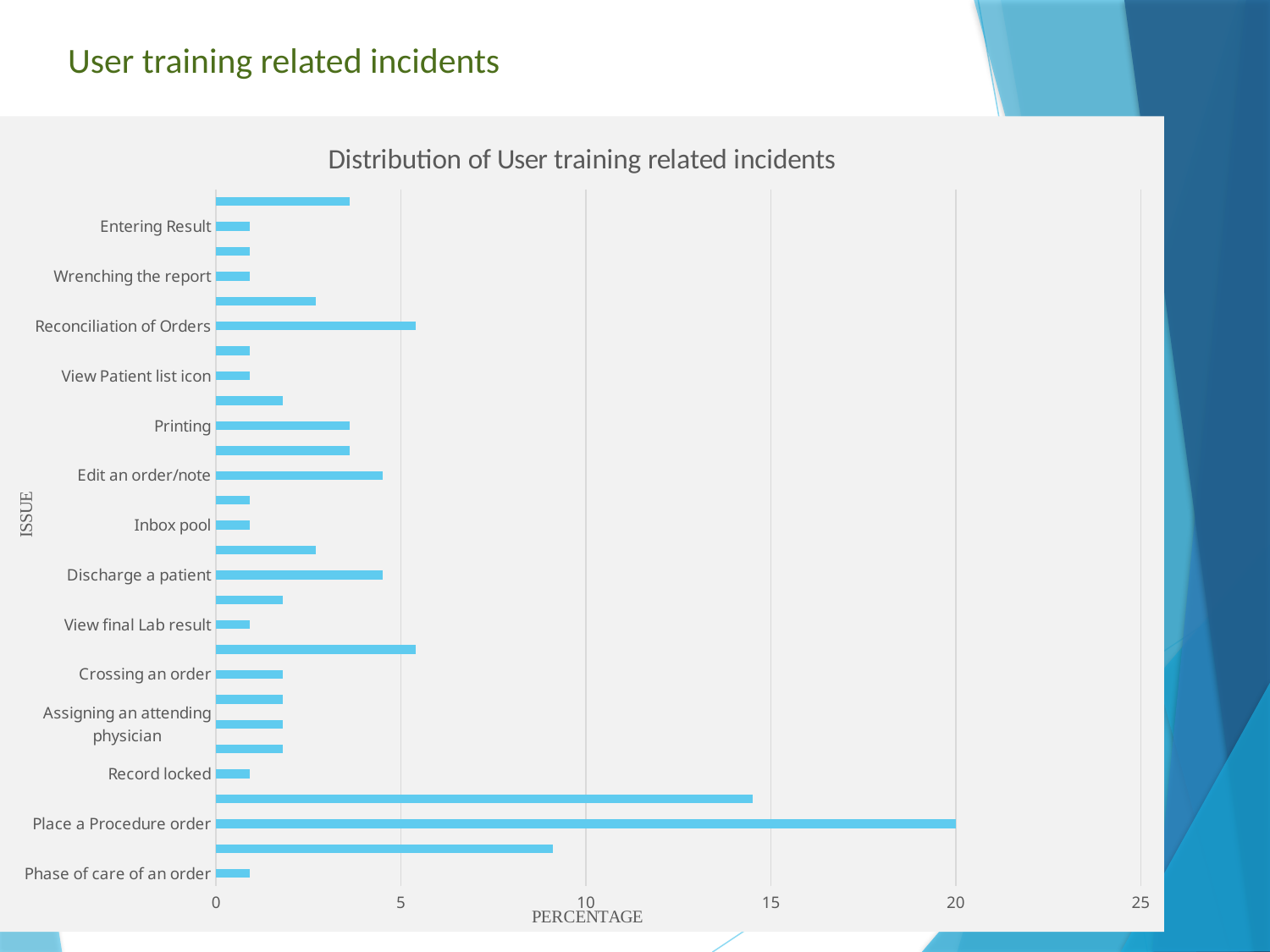
Is the value for Record locked greater or less than 5? less Which is larger, the value for Reconciliation of Orders or the value for Printing? Reconciliation of Orders What is the title of the chart? Distribution of User training related incidents Which is larger, the value for Place a Procedure order or the value for Discharge a patient? Place a Procedure order What is the label of the horizontal axis? PERCENTAGE Which labelled issue has the highest percentage? Place a Procedure order Is the value for Reconciliation of Orders greater or less than 10? less Is the value for Printing greater or less than 5? less Which is larger, the value for Edit an order/note or the value for Inbox pool? Edit an order/note What kind of chart is shown on the slide? bar chart